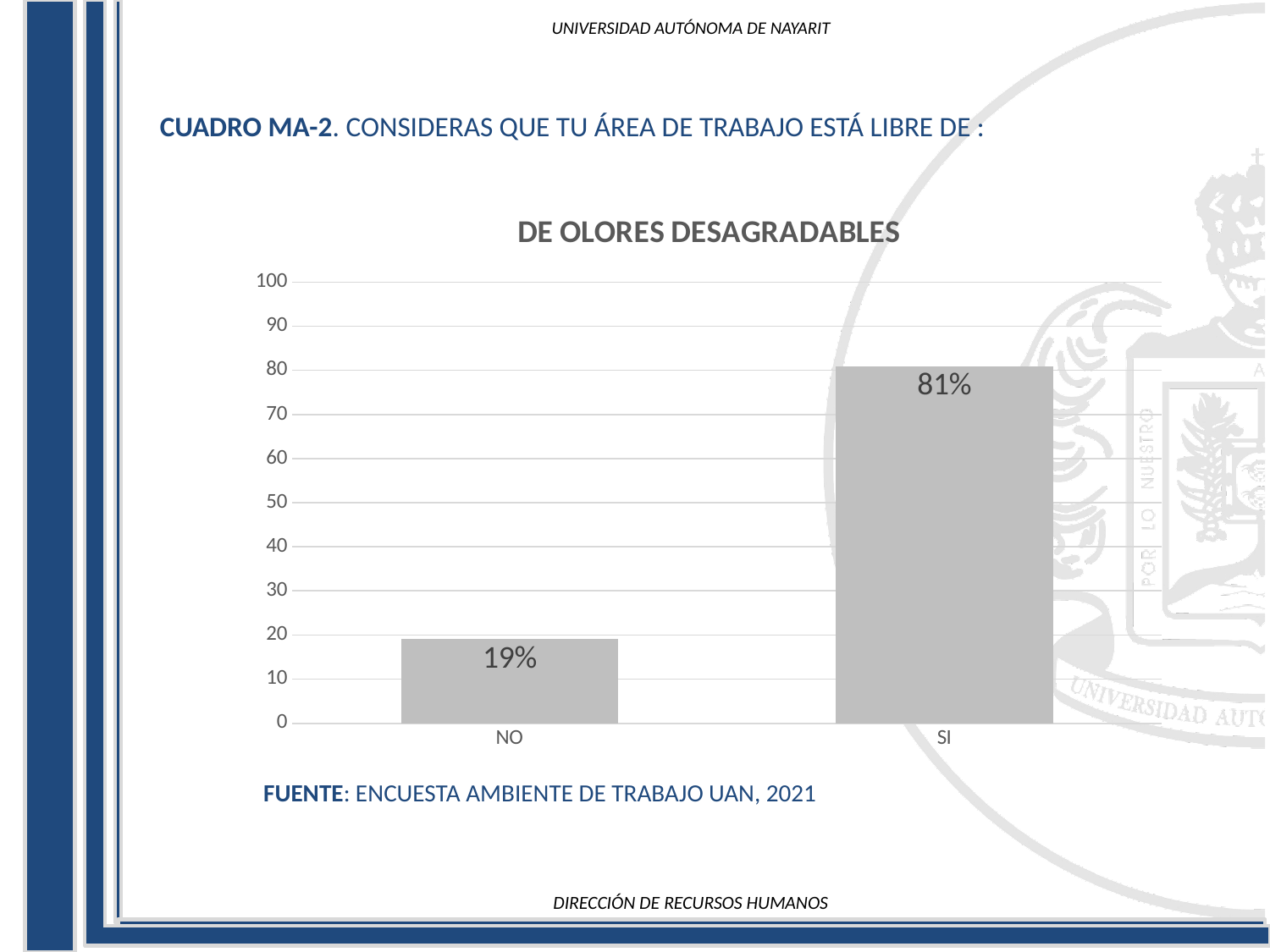
Which is larger, the value for NO or the value for SI? SI What is the value for NO? 19% What is the maximum value shown on the y axis? 100 What is the difference between the values for SI and NO? 62% Which category has the lowest value? NO How many categories are shown on the x axis? 2 Is the value for NO greater or less than 30? less What is the title of the chart? DE OLORES DESAGRADABLES What is the value for SI? 81% What kind of chart is shown? bar chart Is the value for SI greater or less than 50? greater Which category has the highest value? SI